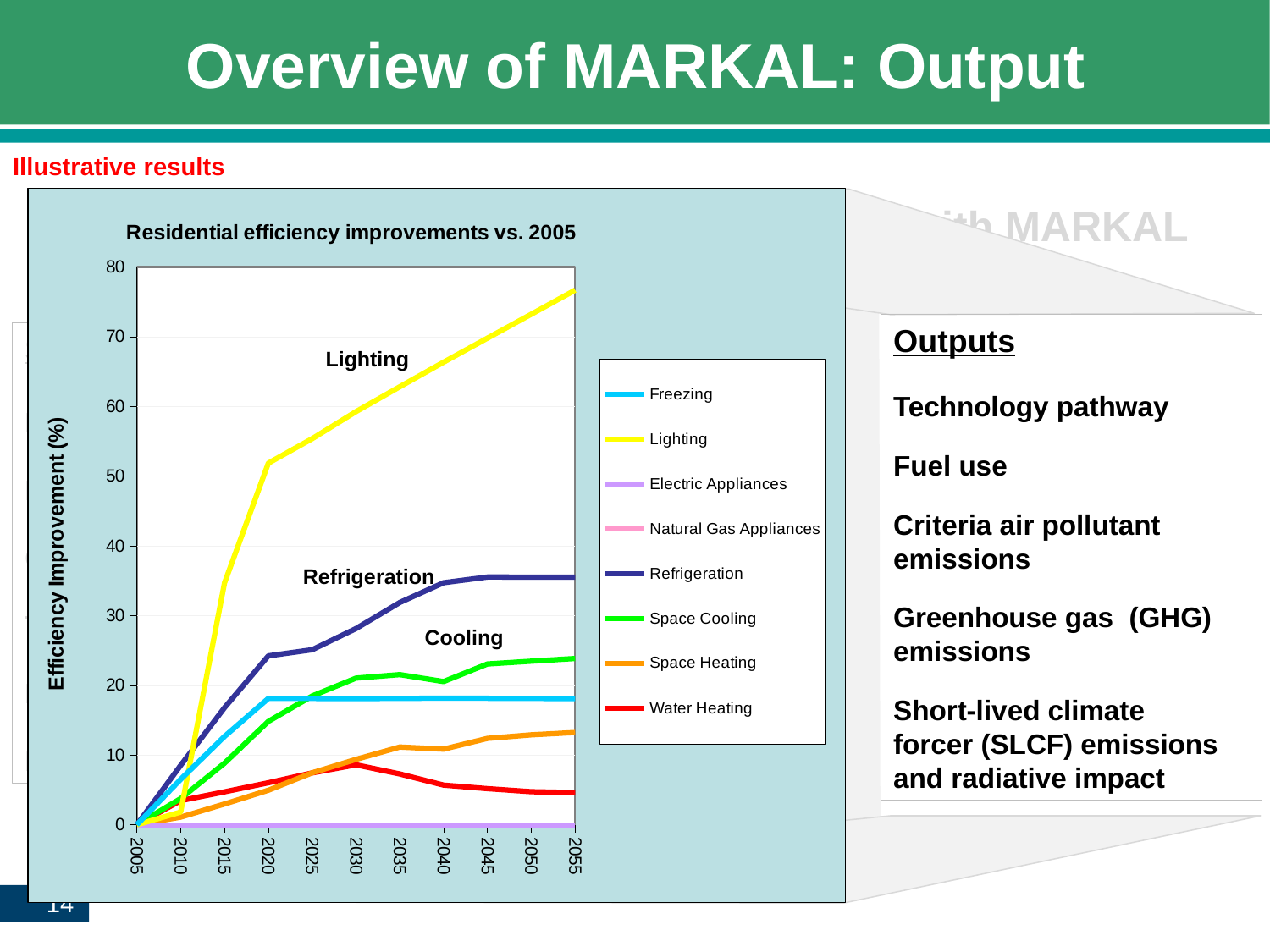
How many series does the legend of the chart list? 8 Is the value for Freezing in 2055 greater or less than 20? less Does the Lighting series rise or fall from 2005 to 2055? rise What is the title of the chart? Residential efficiency improvements vs. 2005 Is the value for Space Heating in 2055 greater or less than 10? greater How many years are marked along the x axis of the chart? 11 Is the value for Lighting in 2055 greater or less than 70? greater Which series has the highest efficiency improvement in 2055? Lighting What kind of chart is shown on the slide? line chart In 2055, which is larger: Refrigeration or Space Cooling? Refrigeration